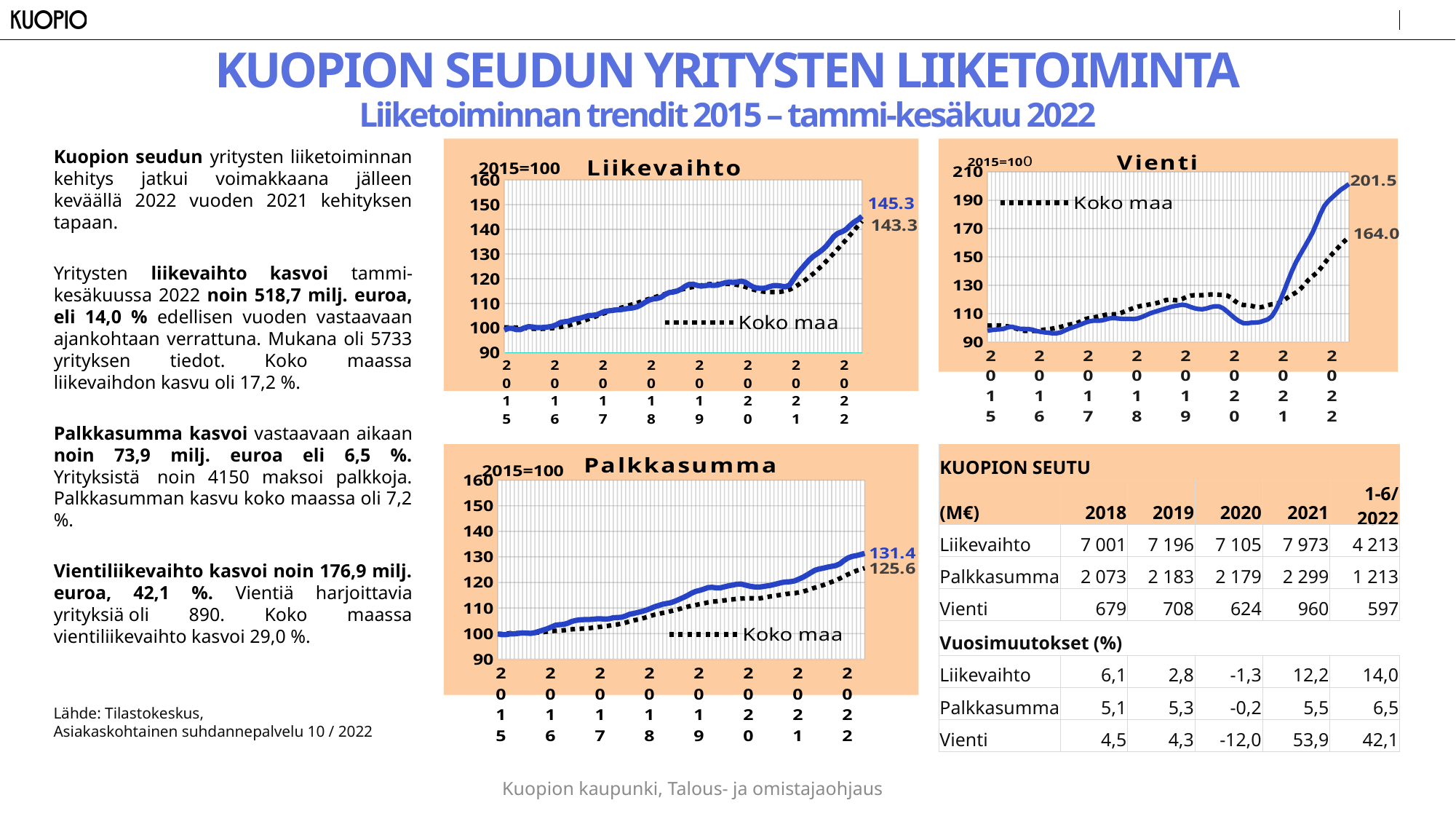
In the Vienti chart, what is the final labelled value of the Koko maa line in 2022? 164.0 In the Palkkasumma chart, what is the difference between the final labelled values of the blue line and the Koko maa line? 5.8 What is the base year index noted on the Palkkasumma chart? 2015=100 In the Liikevaihto chart, what is the final labelled value of the dotted Koko maa line in 2022? 143.3 In the Vienti chart, what is the final labelled value of the blue line in 2022? 201.5 In the Liikevaihto chart, what is the final labelled value of the blue (Kuopion seutu) line in 2022? 145.3 How many years are labelled on the x axis of the Liikevaihto chart? 8 In the Palkkasumma chart, is the 2022 value of the Koko maa line greater or less than 120? greater What kind of chart is the Liikevaihto chart? line chart In the Palkkasumma chart, what is the final labelled value of the blue line in 2022? 131.4 In the Vienti chart, which line ends higher in 2022, the blue line or the Koko maa line? the blue line In the Vienti chart, what is the difference between the final labelled values of the blue line and the Koko maa line? 37.5